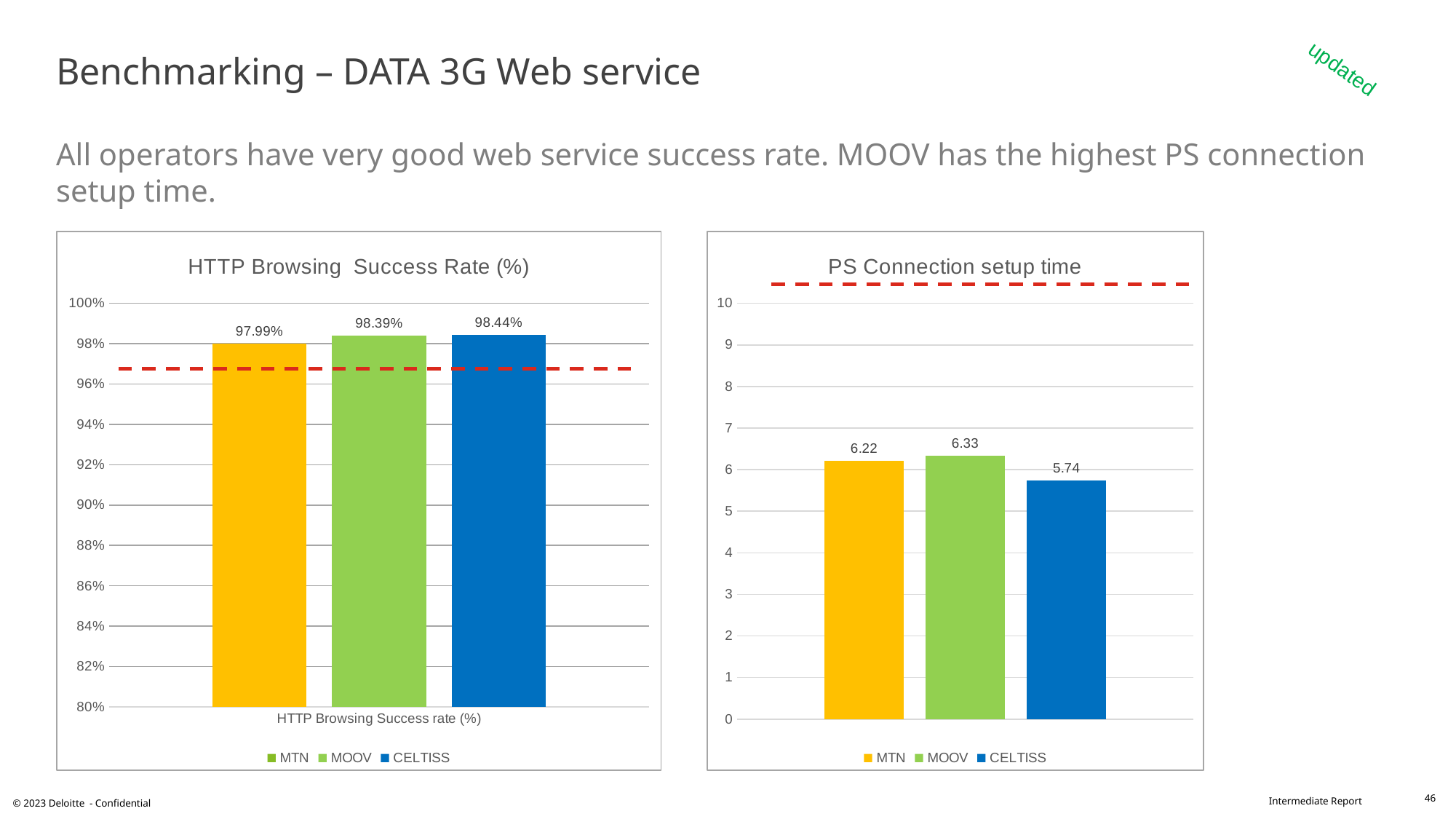
In the PS Connection setup time chart, which operator has the highest setup time? MOOV In the HTTP Browsing Success Rate (%) chart, what is the value for MTN? 97.99% In the HTTP Browsing Success Rate (%) chart, what is the difference between CELTISS and MTN? 0.45% In the HTTP Browsing Success Rate (%) chart, which operator has the lowest success rate? MTN In the HTTP Browsing Success Rate (%) chart, what is the value for CELTISS? 98.44% In the PS Connection setup time chart, is the value for MTN greater or less than 6? greater In the PS Connection setup time chart, what is the difference between MOOV and CELTISS? 0.59 In the PS Connection setup time chart, what is the value for MOOV? 6.33 In the PS Connection setup time chart, which operator has the lowest setup time? CELTISS How many series does the legend of the PS Connection setup time chart list? 3 In the PS Connection setup time chart, what is the value for CELTISS? 5.74 What kind of chart is the HTTP Browsing Success Rate (%) chart? Bar chart